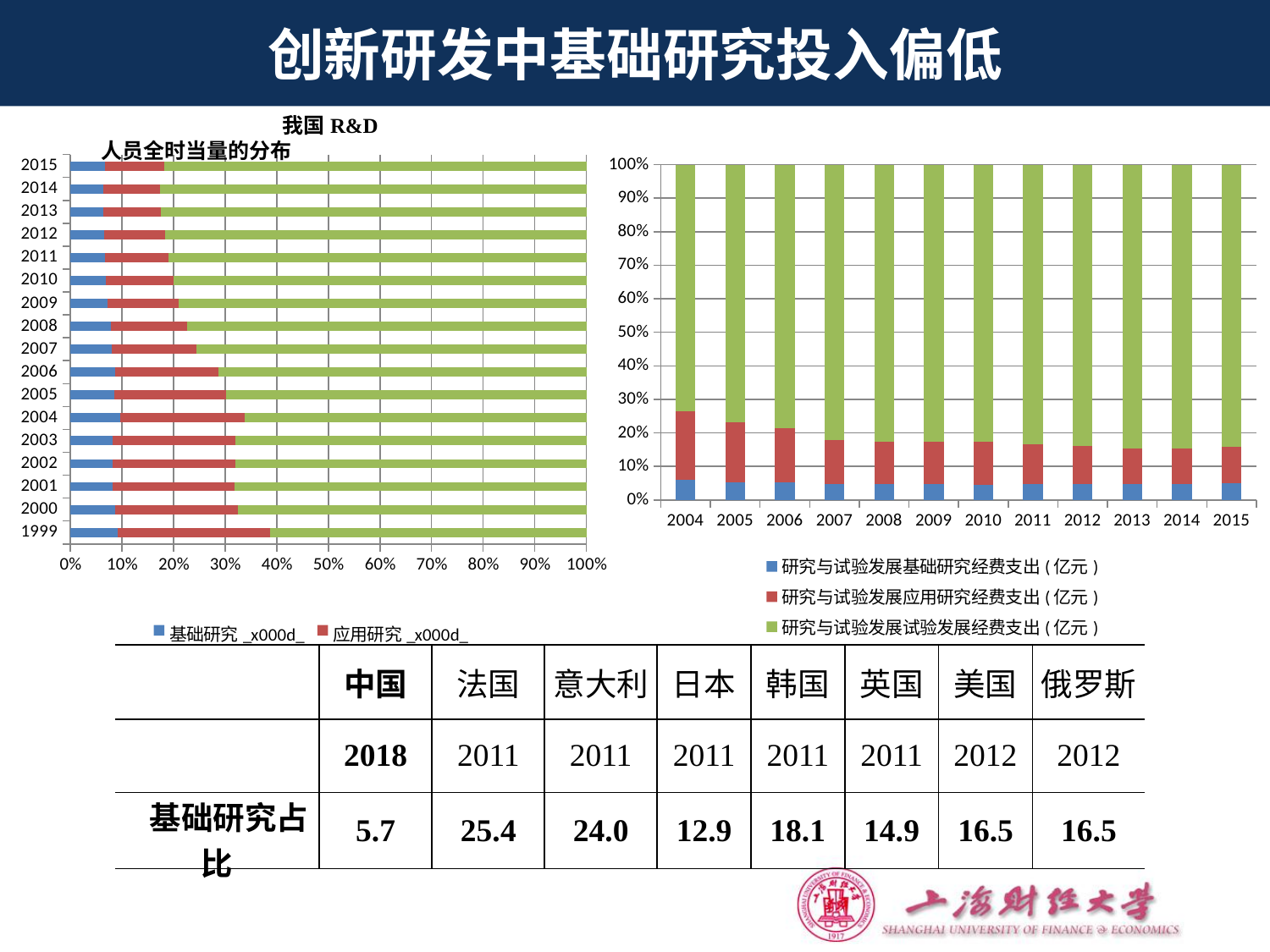
How many years are shown on the x axis of the right chart? 12 How many series does the legend of the right chart list? 3 In the right chart, is the combined share of 基础研究 and 应用研究 in 2015 greater or less than 20%? less In the right chart, does the combined share of 基础研究 and 应用研究 rise or fall from 2004 to 2015? fall In the right chart, which year has the largest share for 研究与试验发展应用研究经费支出? 2004 In the left chart titled 我国R&D人员全时当量的分布, is the value for 基础研究 in 2015 greater or less than 10%? less In the left chart titled 我国R&D人员全时当量的分布, which year has the largest share for 应用研究? 1999 In the right chart, is the value for 研究与试验发展基础研究经费支出 in 2004 greater or less than 10%? less How many years are shown on the vertical axis of the left chart titled 我国R&D人员全时当量的分布? 17 What kind of chart is the left chart titled 我国R&D人员全时当量的分布? bar chart In the left chart titled 我国R&D人员全时当量的分布, is the share for 应用研究 larger in 2004 or in 2015? 2004